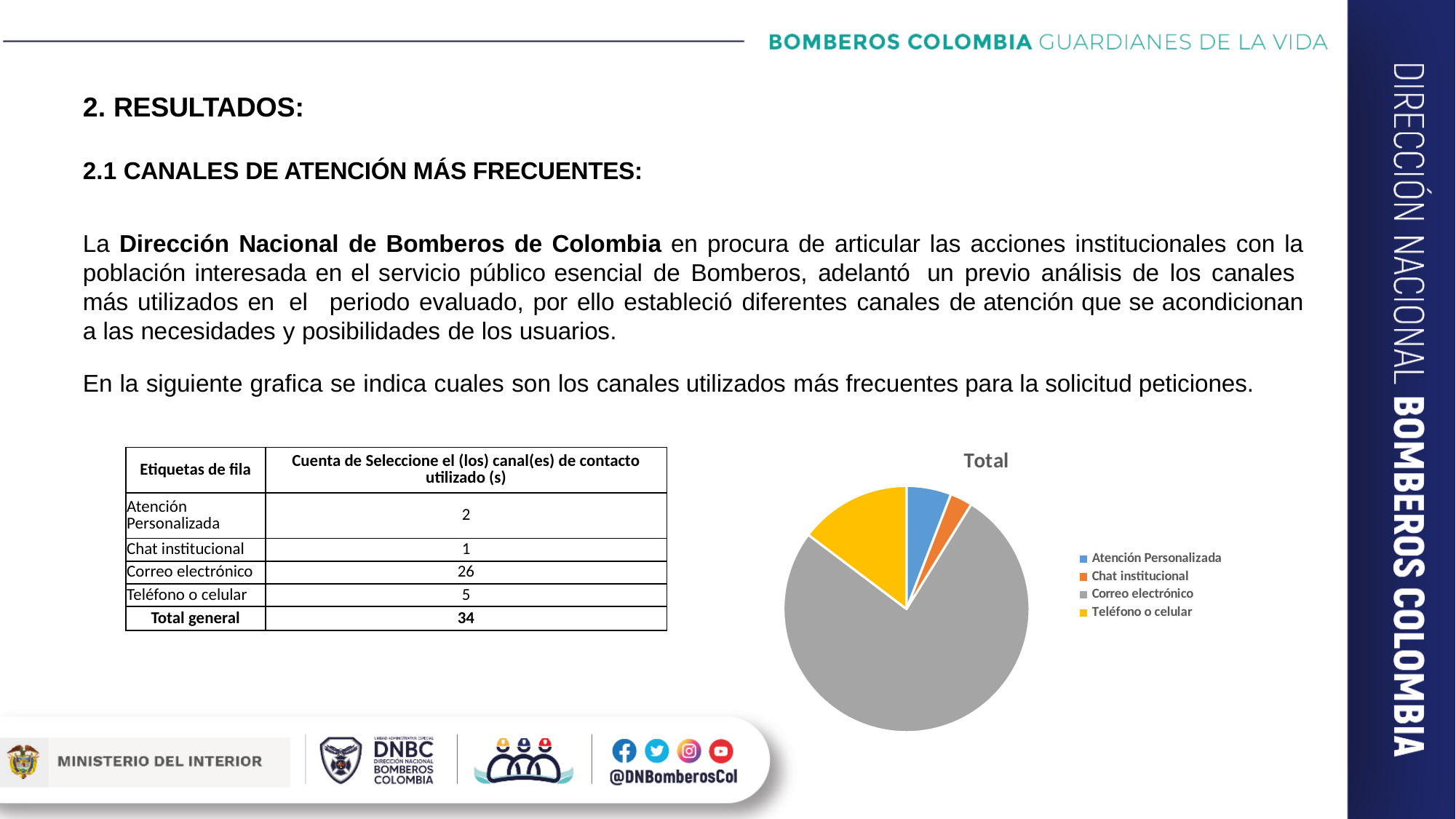
In the pie chart, which slice is larger: Correo electrónico or Teléfono o celular? Correo electrónico What is the title of the pie chart? Total Which category has the largest slice in the pie chart? Correo electrónico How many slices does the pie chart have? 4 Which category has the smallest slice in the pie chart? Chat institucional In the pie chart, which slice is larger: Teléfono o celular or Atención Personalizada? Teléfono o celular What kind of chart is shown on the slide? pie chart How many entries does the legend of the pie chart list? 4 Is the share of Teléfono o celular in the pie chart greater or less than 25%? less Is the share of Correo electrónico in the pie chart greater or less than 50%? greater Which category is shown in yellow in the pie chart? Teléfono o celular In the pie chart, which slice is larger: Atención Personalizada or Chat institucional? Atención Personalizada